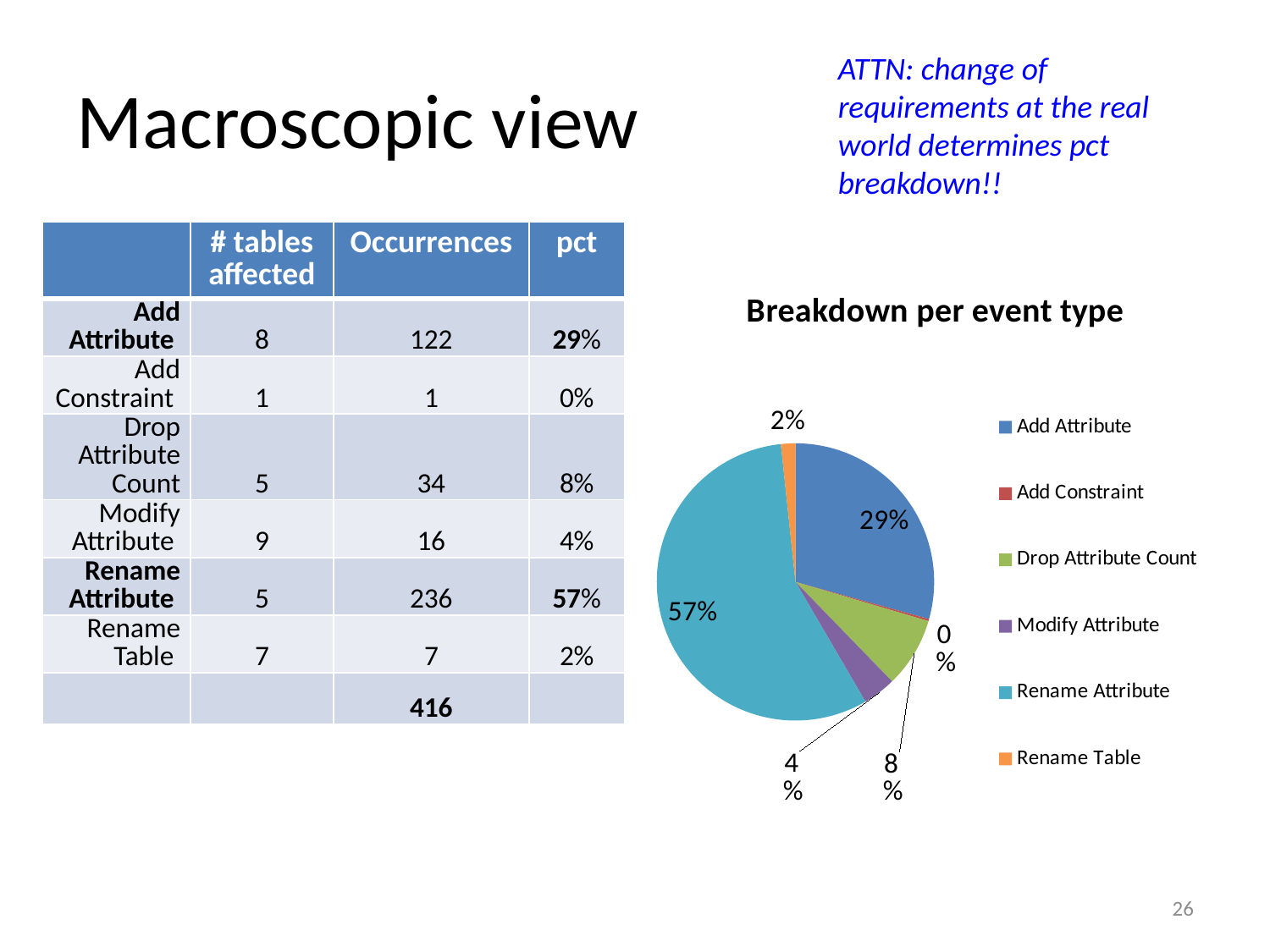
What share of the pie does Modify Attribute have? 4% What kind of chart is shown on the slide? pie chart What share of the pie does Drop Attribute Count have? 8% What is the difference in percentage points between the Rename Attribute slice and the Add Attribute slice? 28% What is the title of the chart? Breakdown per event type What share of the pie does Rename Table have? 2% Which category has the smallest slice of the pie? Add Constraint How many categories does the legend of the pie chart list? 6 Which category has the largest slice of the pie? Rename Attribute Which slice is larger, Add Attribute or Drop Attribute Count? Add Attribute